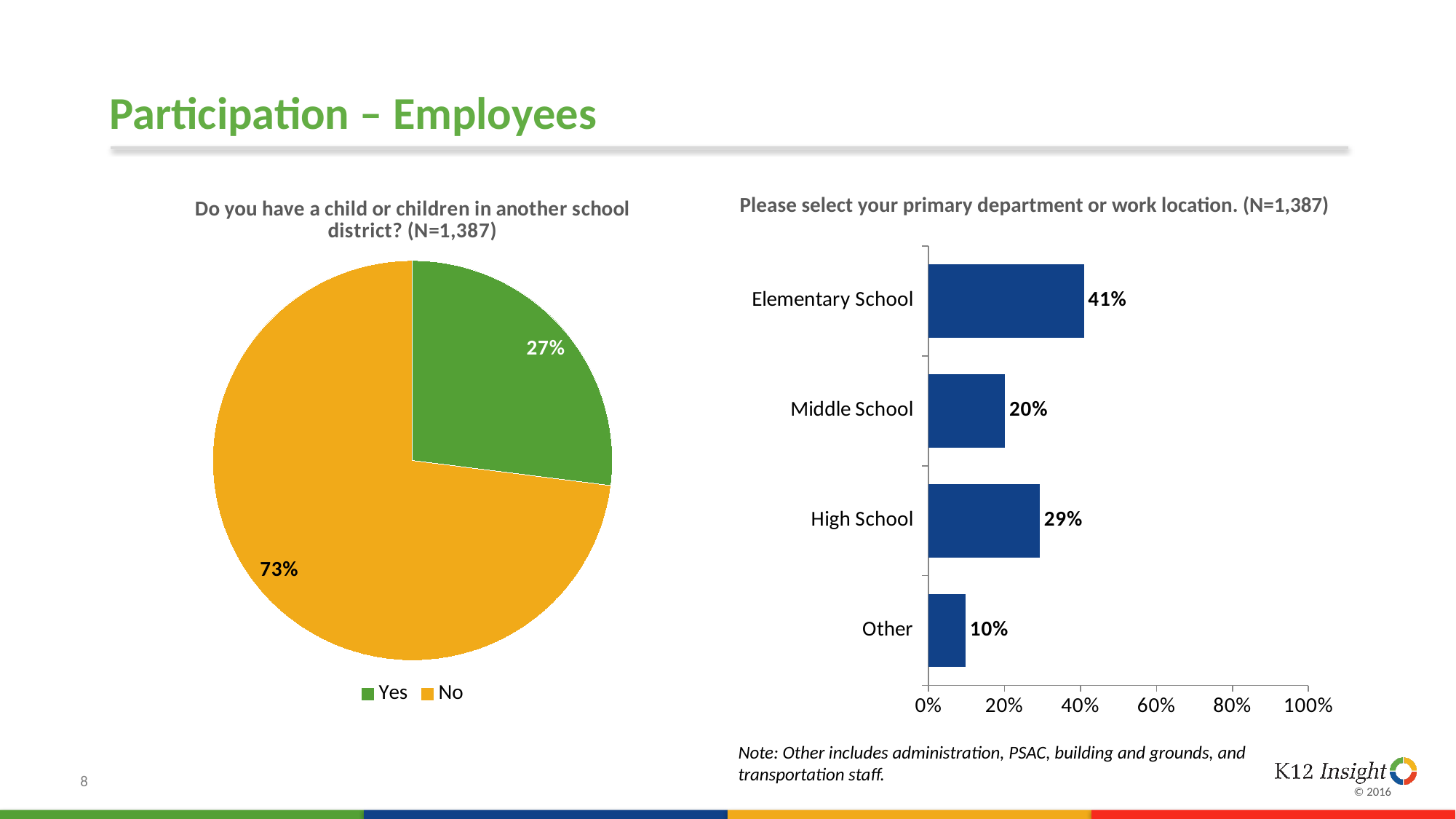
What kind of chart is the chart on the left of the slide? Pie chart What kind of chart is the chart on the right of the slide? Bar chart In the bar chart on the right, which category has the lowest value? Other In the pie chart 'Do you have a child or children in another school district?', what percentage answered Yes? 27% In the bar chart on the right, which category has the highest value? Elementary School In the pie chart 'Do you have a child or children in another school district?', what percentage answered No? 73% How many entries does the legend of the pie chart on the left list? 2 In the bar chart 'Please select your primary department or work location', what is the value for High School? 29% In the bar chart on the right, what is the difference between the values for Elementary School and Middle School? 21% In the pie chart on the left, which response has the larger share, Yes or No? No In the bar chart 'Please select your primary department or work location', what is the value for Elementary School? 41% How many categories are shown in the bar chart on the right? 4